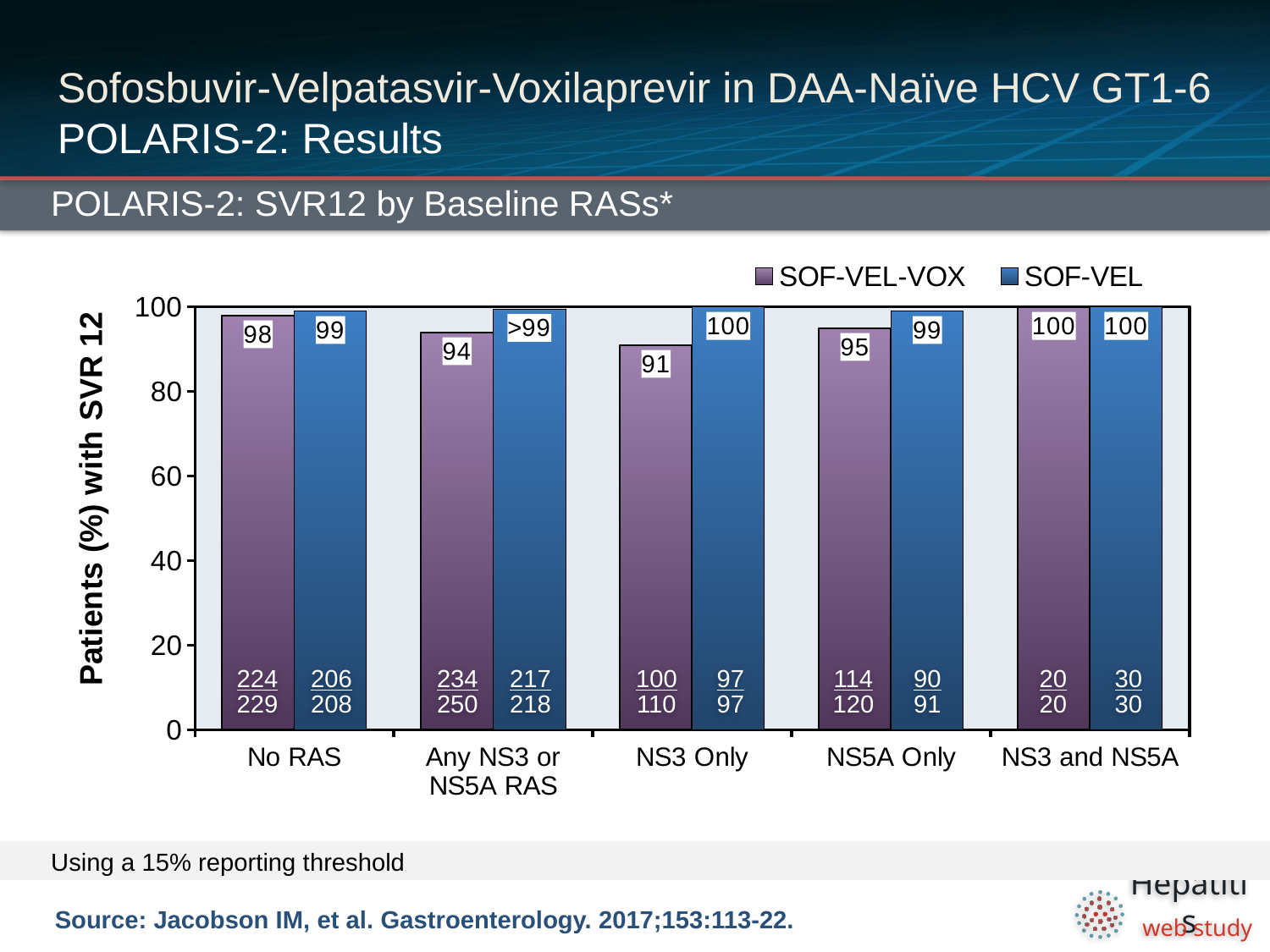
What is the SVR12 rate for SOF-VEL-VOX in the No RAS group? 98 In the NS3 Only group, which regimen has the higher SVR12 rate, SOF-VEL-VOX or SOF-VEL? SOF-VEL What is the SVR12 rate for SOF-VEL in the Any NS3 or NS5A RAS group? >99 What is the difference between the SOF-VEL and SOF-VEL-VOX SVR12 rates in the NS5A Only group? 4 What is the SVR12 rate for SOF-VEL-VOX in the NS3 Only group? 91 What type of chart is shown on the slide? Bar chart What is the label of the y axis? Patients (%) with SVR 12 How many patients out of how many achieved SVR12 with SOF-VEL-VOX in the Any NS3 or NS5A RAS group? 234/250 How many baseline RAS categories are shown on the x axis? 5 How many series does the legend list? 2 Which baseline RAS category has the lowest SVR12 rate for SOF-VEL-VOX? NS3 Only What is the SVR12 rate for SOF-VEL-VOX in the NS3 and NS5A group? 100